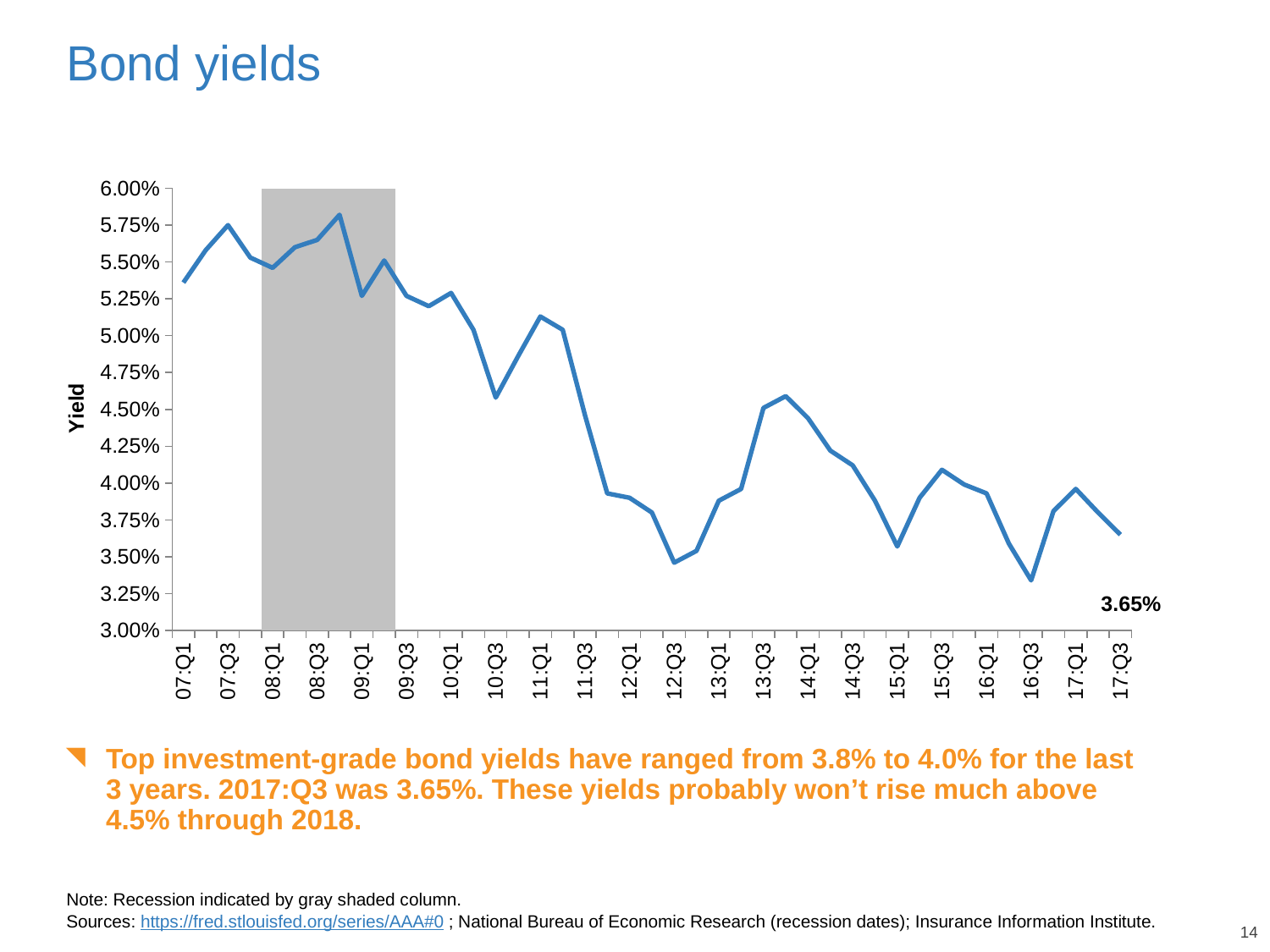
Overall, do bond yields rise or fall from 07:Q1 to 17:Q3? fall What kind of chart is used to show bond yields? line chart Is the yield at 10:Q3 greater or less than 4.75%? less Which has the higher yield, 13:Q3 or 15:Q3? 13:Q3 Which quarter has the lowest bond yield on the chart? 16:Q3 What does the gray shaded column on the chart indicate? Recession Is the yield at 07:Q1 greater or less than 5.25%? greater What is the bond yield value labeled at 17:Q3? 3.65% Which has the higher yield, 07:Q1 or 17:Q3? 07:Q1 Is the yield at 16:Q3 greater or less than 3.50%? less What is the title of the vertical axis? Yield